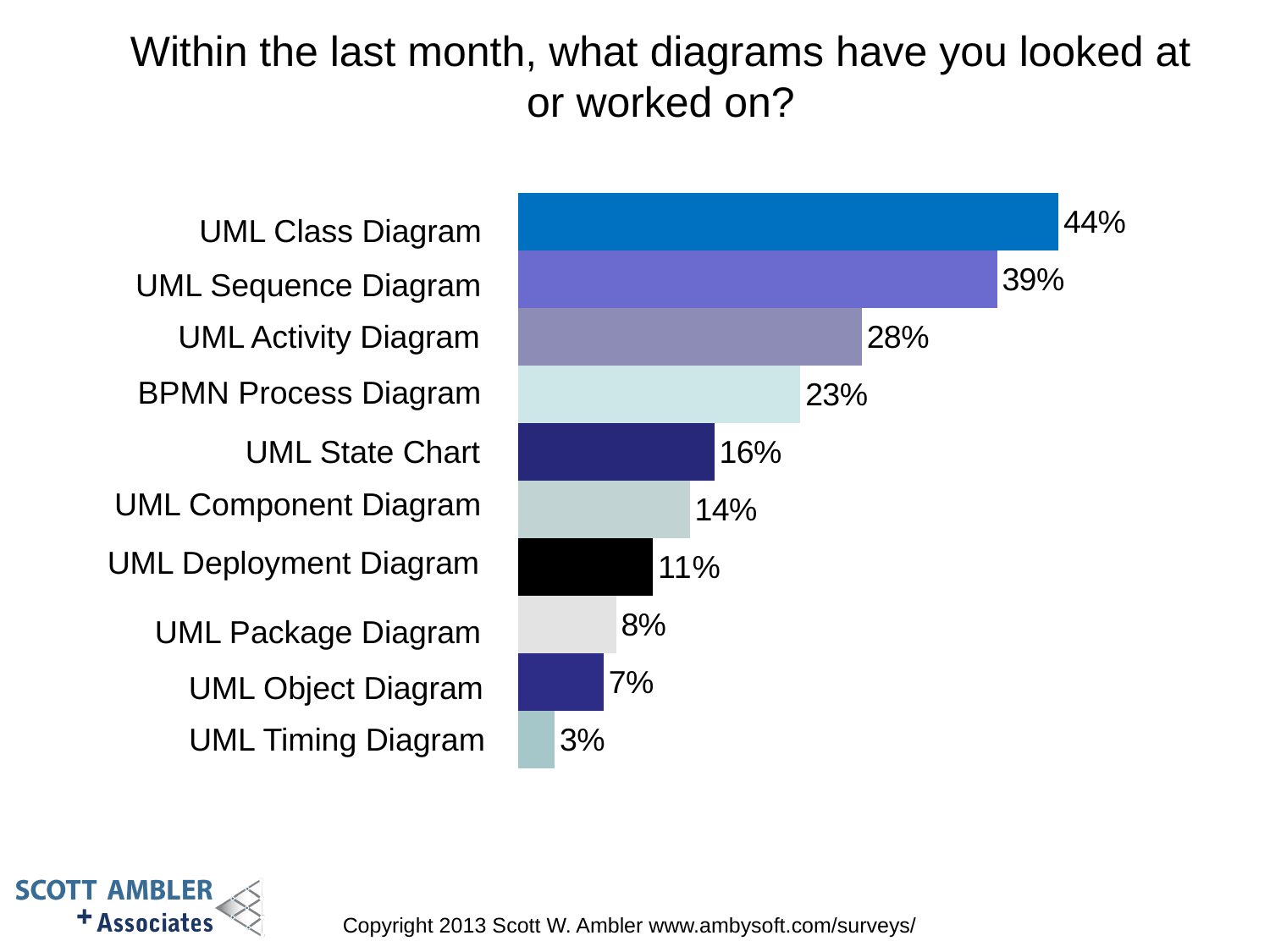
Which diagram has the lowest percentage? UML Timing Diagram What is the difference between the values for UML Class Diagram and UML Sequence Diagram? 5% What is the difference between the values for UML State Chart and UML Component Diagram? 2% Which diagram has the highest percentage? UML Class Diagram How many diagram types are shown in the chart? 10 What percentage of respondents looked at or worked on a UML Class Diagram? 44% What kind of chart is shown on the slide? Bar chart What is the title of the chart? Within the last month, what diagrams have you looked at or worked on? Which has a larger value, UML Activity Diagram or BPMN Process Diagram? UML Activity Diagram What is the value shown for BPMN Process Diagram? 23% Which has a larger value, UML Package Diagram or UML Object Diagram? UML Package Diagram What is the value shown for UML Deployment Diagram? 11%